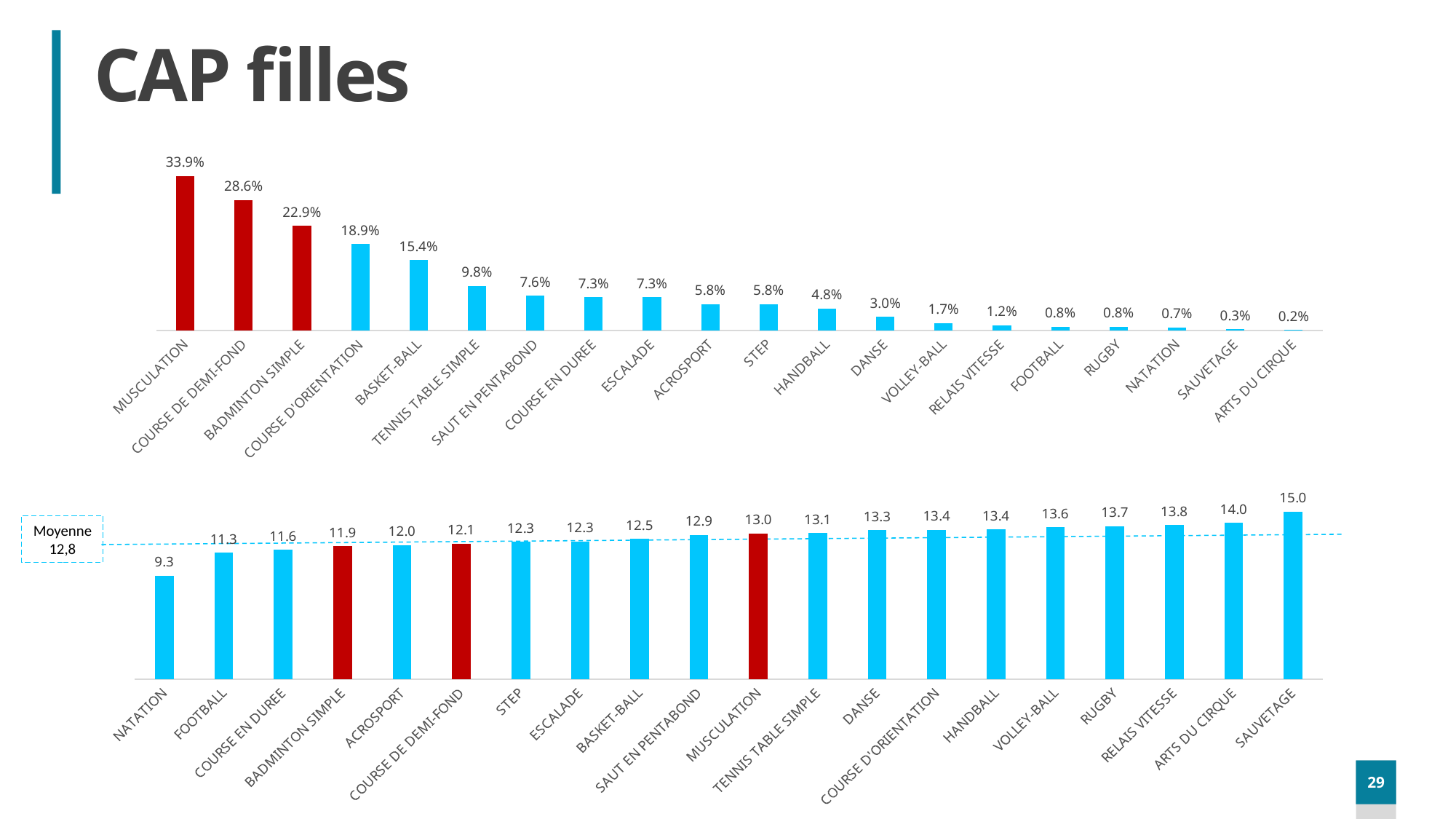
In the top chart, how many categories are shown? 20 In the bottom chart, what is the value for MUSCULATION? 13.0 In the bottom chart, which category has the lowest value? NATATION What value is given for the 'Moyenne' dashed line on the bottom chart? 12,8 What type of chart is the top chart? bar chart In the top chart, which category has the lowest value? ARTS DU CIRQUE In the bottom chart, what is the value for SAUVETAGE? 15.0 In the top chart, what is the difference between COURSE DE DEMI-FOND and BADMINTON SIMPLE? 5.7% In the bottom chart, which is larger, the value for FOOTBALL or the value for RUGBY? RUGBY In the bottom chart, what is the difference between ARTS DU CIRQUE and NATATION? 4.7 In the top chart, do the values rise or fall from left to right? fall In the top chart, what is the value for MUSCULATION? 33.9%